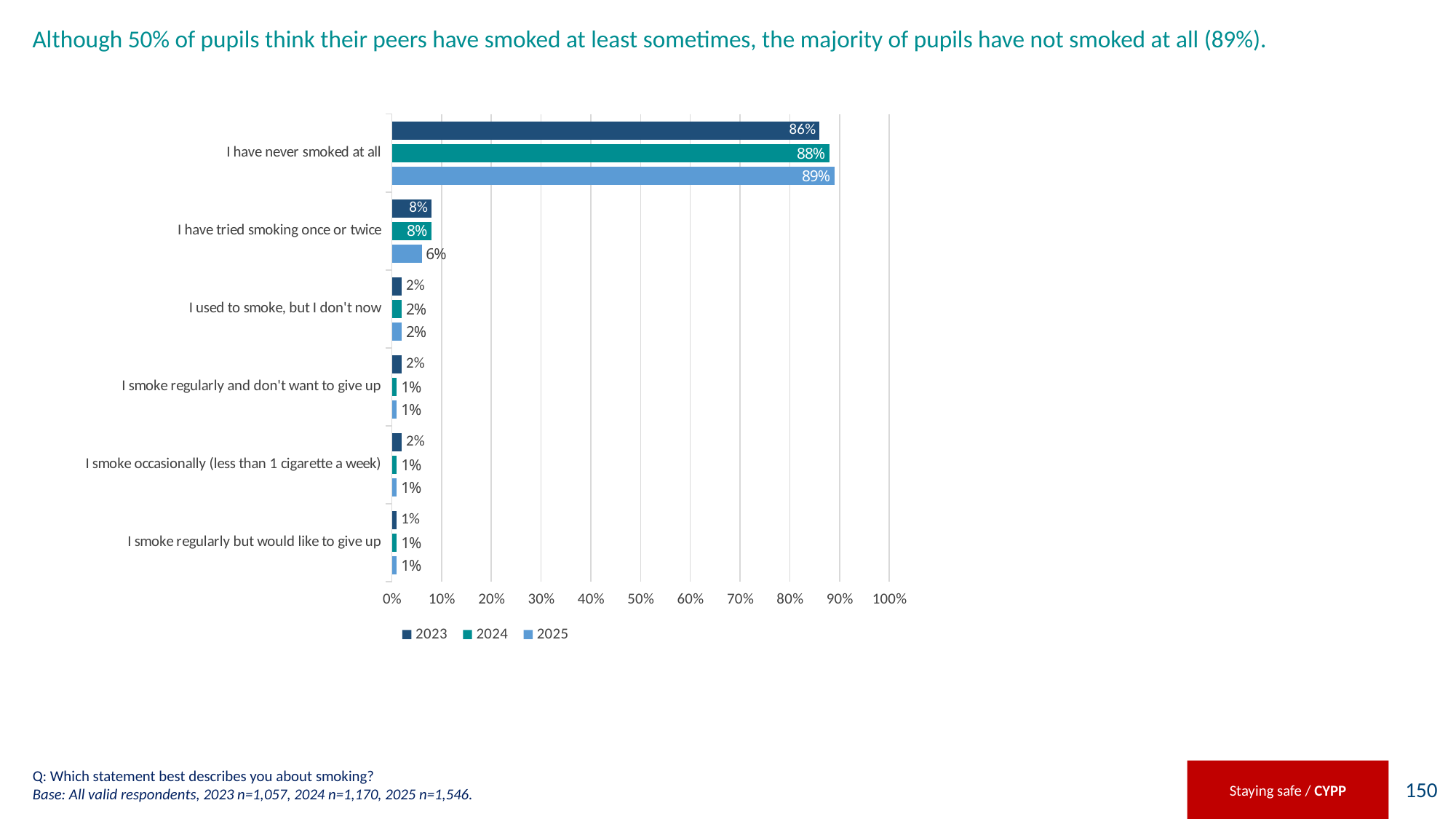
Which is larger: the 2024 value for 'I have never smoked at all' or the 2023 value for the same statement? 2024 Is the 2025 value for 'I have never smoked at all' greater or less than 80%? greater What is the difference between the 2025 and 2023 values for 'I have never smoked at all'? 3 percentage points What percentage of pupils said 'I have never smoked at all' in 2025? 89% Which statement has the highest value in 2025? I have never smoked at all How many statement categories are shown on the chart? 6 What is the difference between the 2023 and 2025 values for 'I have tried smoking once or twice'? 2 percentage points What kind of chart is shown on the slide? Bar chart How many series does the legend list? 3 What percentage of pupils said 'I have tried smoking once or twice' in 2023? 8% Did the value for 'I have never smoked at all' rise or fall from 2023 to 2025? Rise What is the 2024 value for 'I used to smoke, but I don't now'? 2%